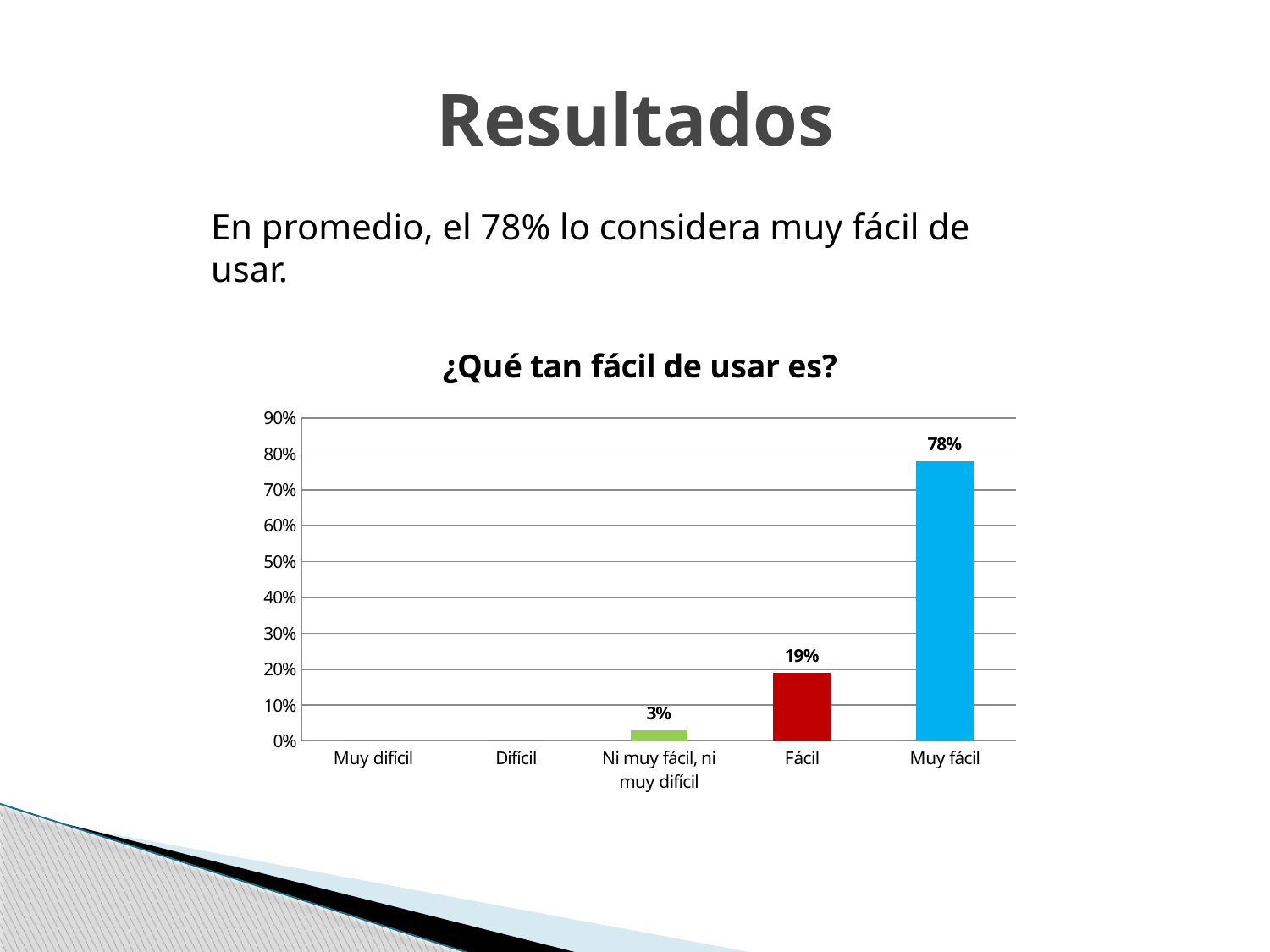
What is the value for Fácil? 19% Is the value for Muy fácil greater or less than 70%? greater Is the value for Fácil greater or less than 20%? less How many categories are shown on the x axis? 5 What is the difference between the values for Muy fácil and Fácil? 59% What is the value for Ni muy fácil, ni muy difícil? 3% What is the title of the chart? ¿Qué tan fácil de usar es? What is the difference between the values for Fácil and Ni muy fácil, ni muy difícil? 16% What is the value for Muy fácil? 78% Which category has the highest value? Muy fácil Which is larger, the value for Fácil or the value for Ni muy fácil, ni muy difícil? Fácil What kind of chart is shown on the slide? bar chart